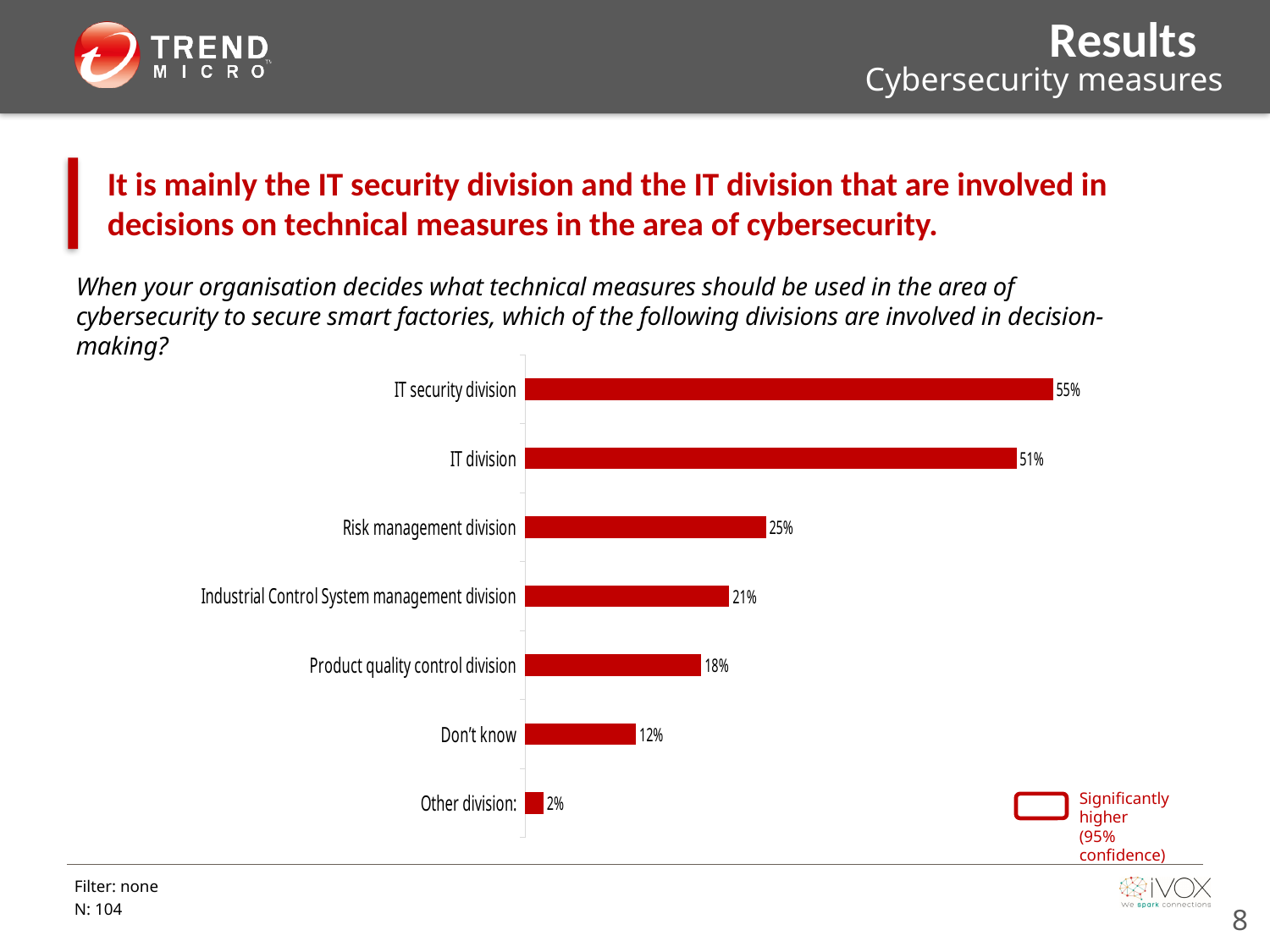
How many categories are shown in the chart? 7 What is the value for the Risk management division? 25% Which category has the lowest percentage? Other division: Which division has the highest percentage? IT security division What colour are the bars in the chart? Red What percentage is shown for the Industrial Control System management division? 21% What is the difference between the Risk management division and the Product quality control division? 7% What type of chart is shown on the slide? Bar chart What is the difference between the IT security division and the IT division? 4% Which is larger, the value for the IT division or the value for the Risk management division? IT division What percentage is shown for the IT security division? 55% What is the value for Don't know? 12%